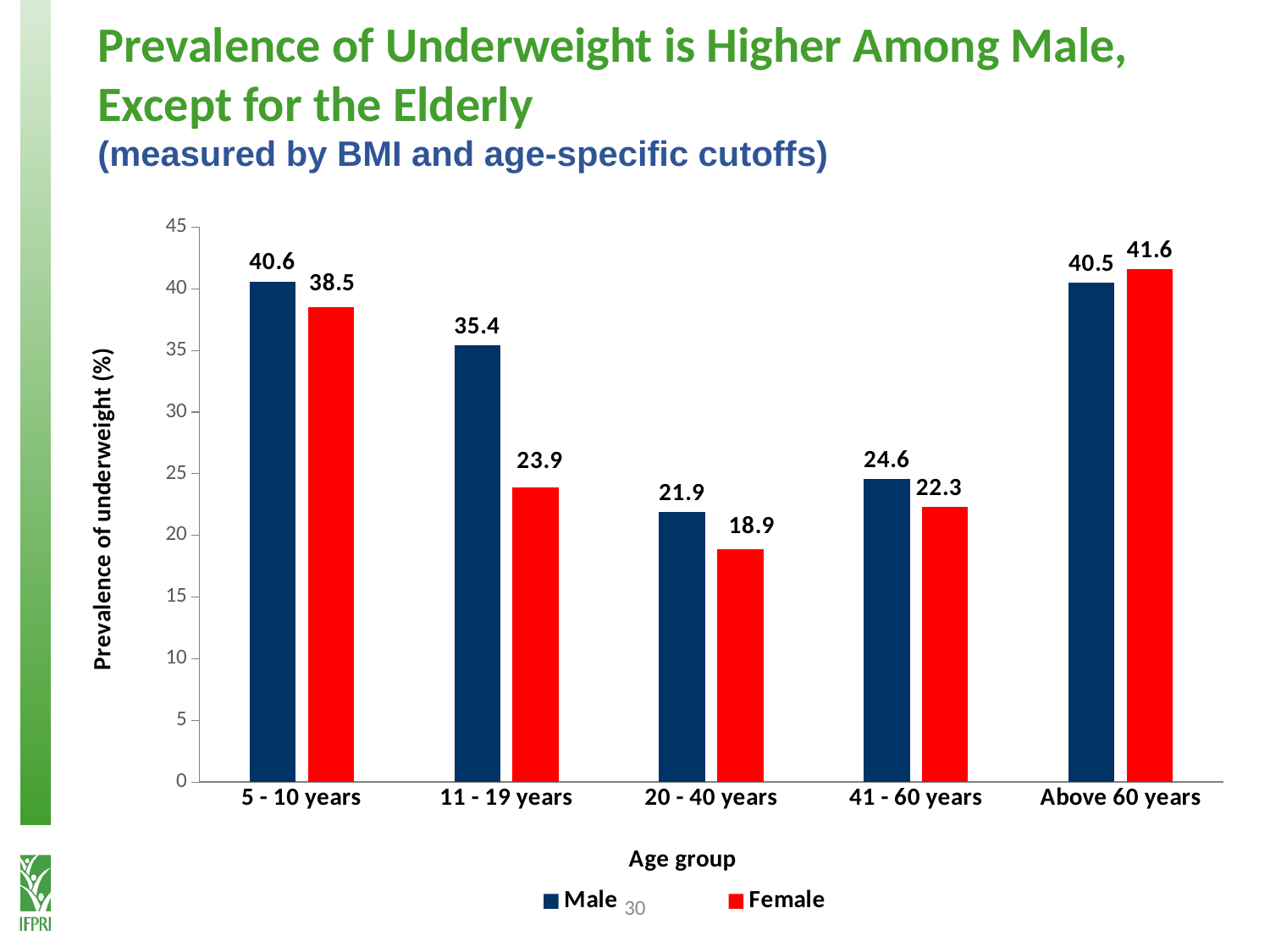
What is the prevalence of underweight for females above 60 years? 41.6 What kind of chart is shown on the slide? Bar chart In the Above 60 years age group, which is larger, the male or the female prevalence of underweight? Female What is the difference between the male and female prevalence of underweight in the 11 - 19 years age group? 11.5 How many age groups are shown on the x axis? 5 What is the label of the y axis? Prevalence of underweight (%) How many series does the legend list? 2 What is the prevalence of underweight for males aged 5 - 10 years? 40.6 Which age group has the highest prevalence of underweight among males? 5 - 10 years Is the male prevalence of underweight for 41 - 60 years greater or less than 20? greater Which age group has the lowest prevalence of underweight among females? 20 - 40 years What is the prevalence of underweight for females aged 20 - 40 years? 18.9